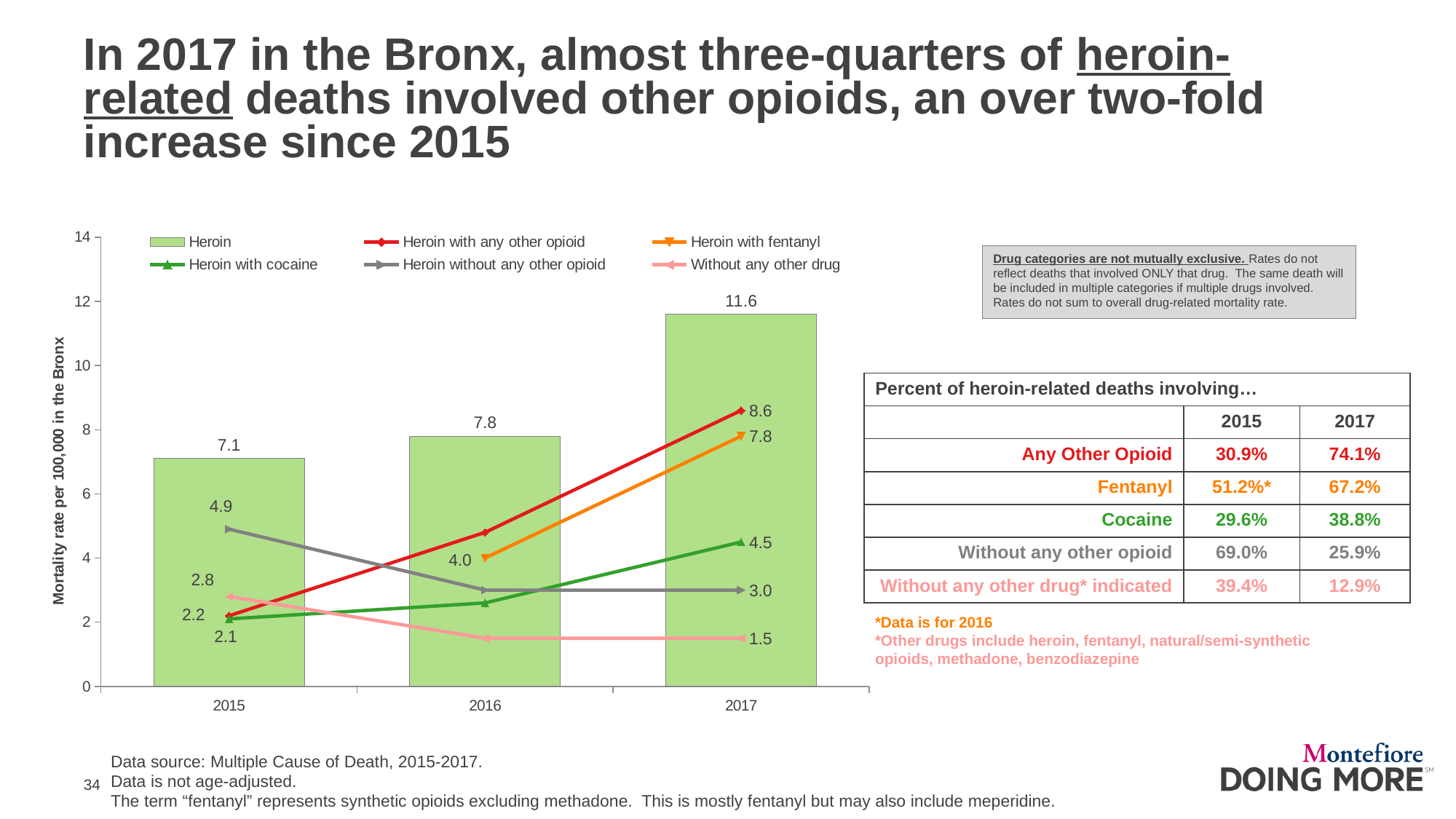
How many years are shown on the x axis of the chart? 3 In 2017, which is larger: Heroin with fentanyl or Heroin with cocaine? Heroin with fentanyl What is the value for Heroin with any other opioid in 2017? 8.6 Do the Heroin bars rise or fall from 2015 to 2017? Rise What is the value for Without any other drug in 2017? 1.5 In which year is the Heroin bar the highest? 2017 How many series does the chart legend list? 6 What kind of chart is shown on the slide? Combination bar and line chart What is the Heroin mortality rate per 100,000 in the Bronx for 2017? 11.6 Is the value for Heroin with any other opioid in 2016 greater or less than 4? greater By how much did the Heroin mortality rate increase from 2015 to 2017? 4.5 What is the value for Heroin without any other opioid in 2015? 4.9